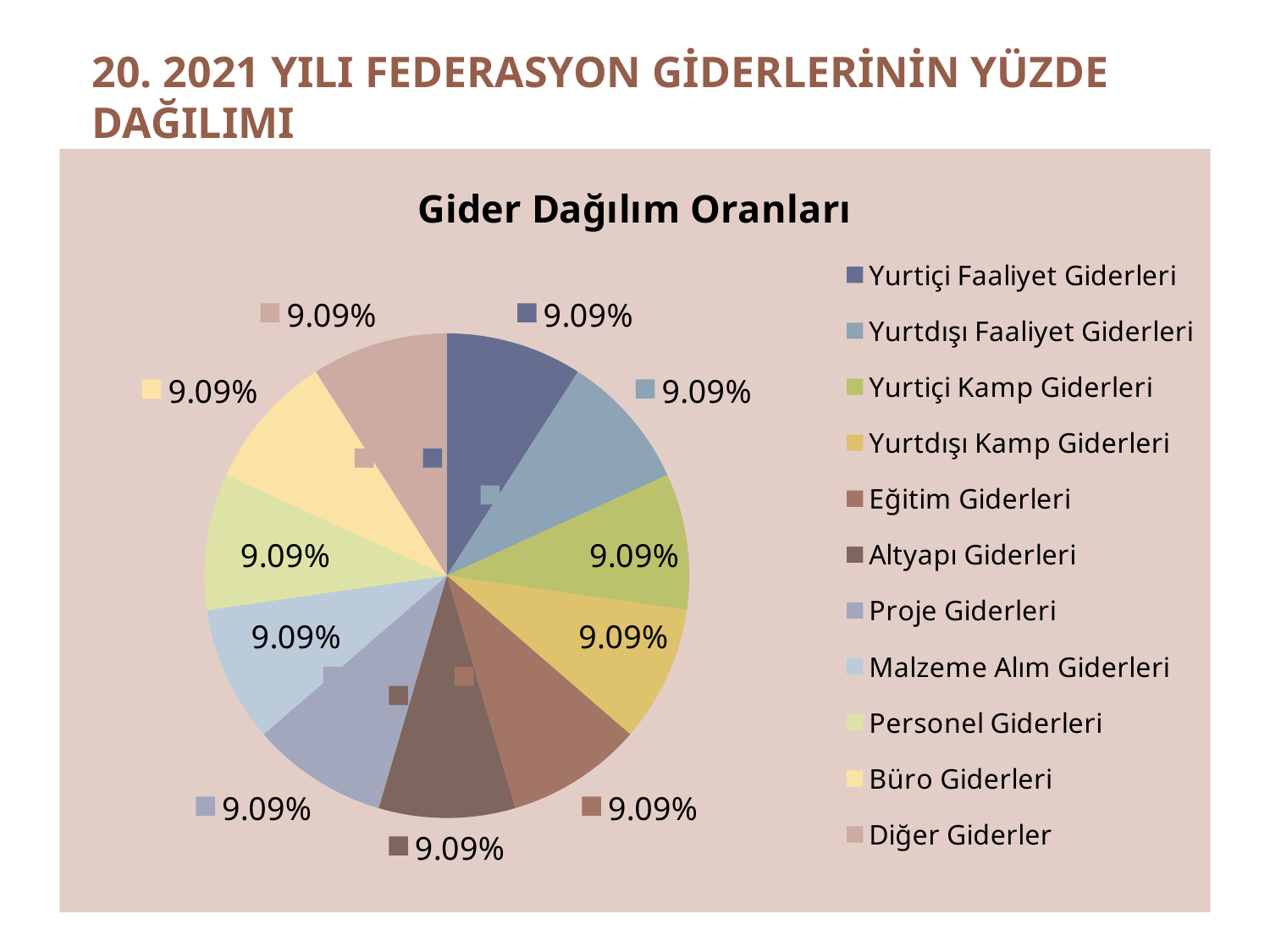
What is the value shown for Diğer Giderler? 9.09% What is the value shown for Personel Giderleri? 9.09% What share of the pie is Yurtiçi Faaliyet Giderleri? 9.09% Which legend entry is listed last? Diğer Giderler What is the chart title? Gider Dağılım Oranları How many slices does the pie chart have? 11 How many entries does the legend list? 11 What is the difference between the values for Eğitim Giderleri and Büro Giderleri? 0% What kind of chart is shown on the slide? pie chart What share of the pie is Altyapı Giderleri? 9.09% What is the value shown for Proje Giderleri? 9.09% What is the value shown for Malzeme Alım Giderleri? 9.09%